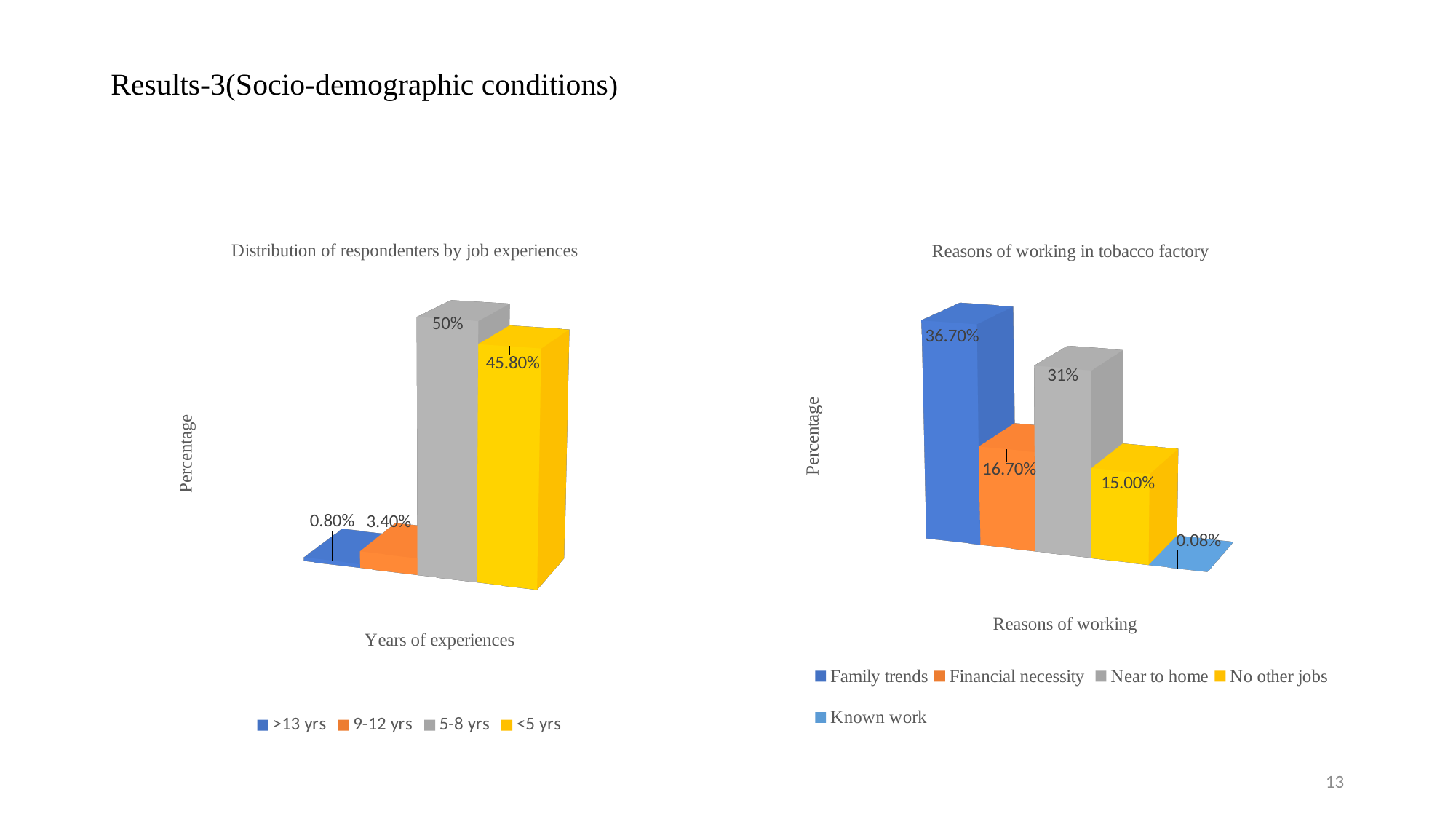
In the 'Reasons of working in tobacco factory' chart, what is the value for Financial necessity? 16.70% In the 'Distribution of respondenters by job experiences' chart, what is the value for 5-8 yrs? 50% In the 'Distribution of respondenters by job experiences' chart, what is the value for >13 yrs? 0.80% What kind of chart is the 'Reasons of working in tobacco factory' chart? Bar chart In the 'Reasons of working in tobacco factory' chart, what is the difference between Family trends and Near to home? 5.70% In the 'Reasons of working in tobacco factory' chart, which is larger, Near to home or No other jobs? Near to home In the 'Reasons of working in tobacco factory' chart, which reason has the highest value? Family trends In the 'Distribution of respondenters by job experiences' chart, what is the difference between the values for 5-8 yrs and <5 yrs? 4.20% In the 'Distribution of respondenters by job experiences' chart, how many categories does the legend list? 4 In the 'Reasons of working in tobacco factory' chart, what is the value for Known work? 0.08% In the 'Distribution of respondenters by job experiences' chart, which category has the lowest value? >13 yrs In the 'Distribution of respondenters by job experiences' chart, which category has the highest value? 5-8 yrs